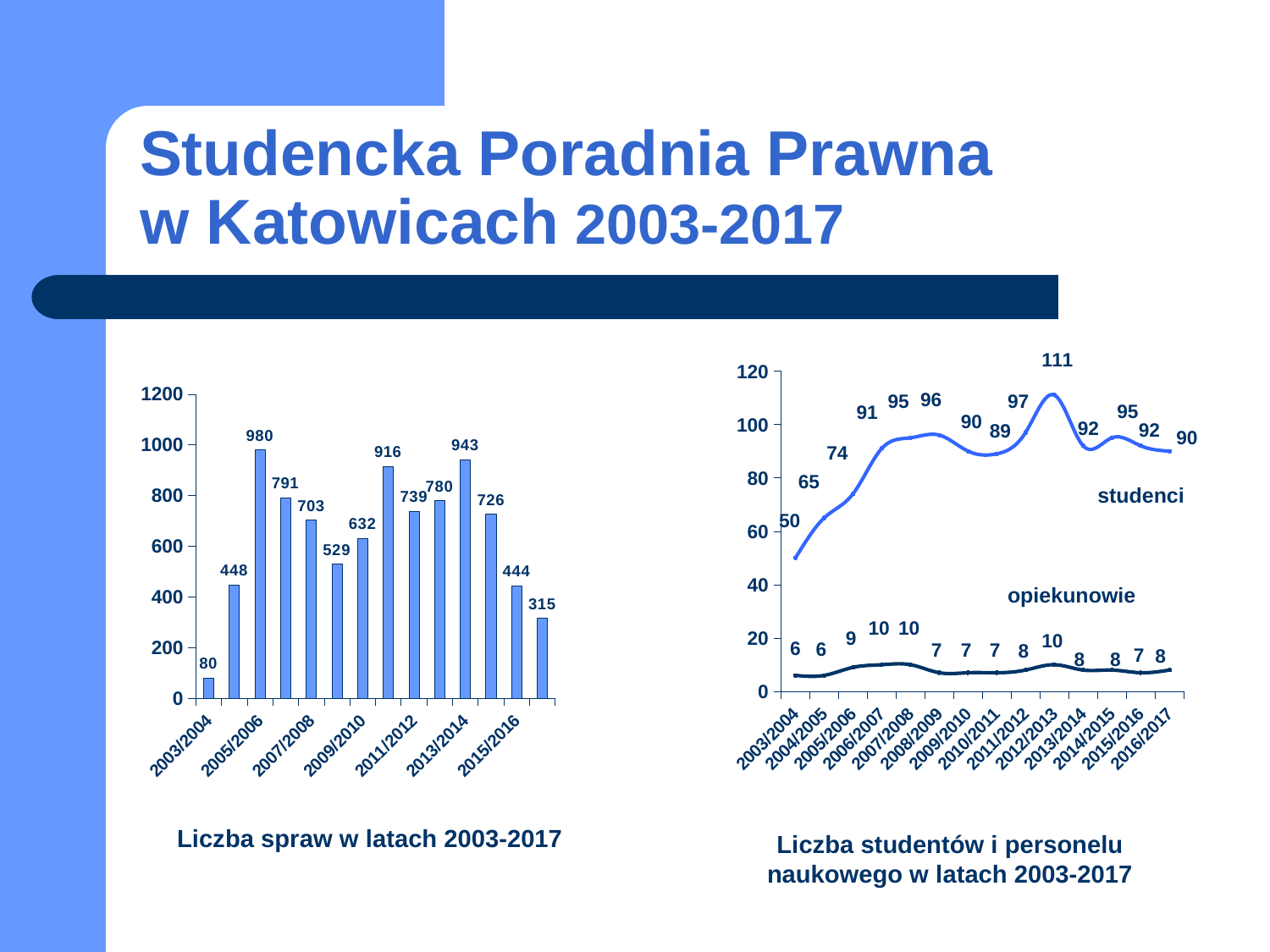
In the right chart 'Liczba studentów i personelu naukowego w latach 2003-2017', what is the opiekunowie value for 2016/2017? 8 What kind of chart is the right chart 'Liczba studentów i personelu naukowego w latach 2003-2017'? line chart How many series are plotted in the right chart 'Liczba studentów i personelu naukowego w latach 2003-2017'? 2 In the right chart 'Liczba studentów i personelu naukowego w latach 2003-2017', what is the highest value of the studenci series? 111 In the left chart 'Liczba spraw w latach 2003-2017', what is the value for 2013/2014? 943 How many bars are plotted in the left chart 'Liczba spraw w latach 2003-2017'? 14 What kind of chart is the left chart titled 'Liczba spraw w latach 2003-2017'? bar chart In the left chart 'Liczba spraw w latach 2003-2017', which year has the lowest value? 2003/2004 In the left chart 'Liczba spraw w latach 2003-2017', is the value for 2009/2010 greater or less than 600? greater In the left chart 'Liczba spraw w latach 2003-2017', which year has the highest number of cases? 2005/2006 In the right chart 'Liczba studentów i personelu naukowego w latach 2003-2017', what is the studenci value for 2003/2004? 50 In the left chart 'Liczba spraw w latach 2003-2017', what is the difference between the values for 2005/2006 and 2003/2004? 900